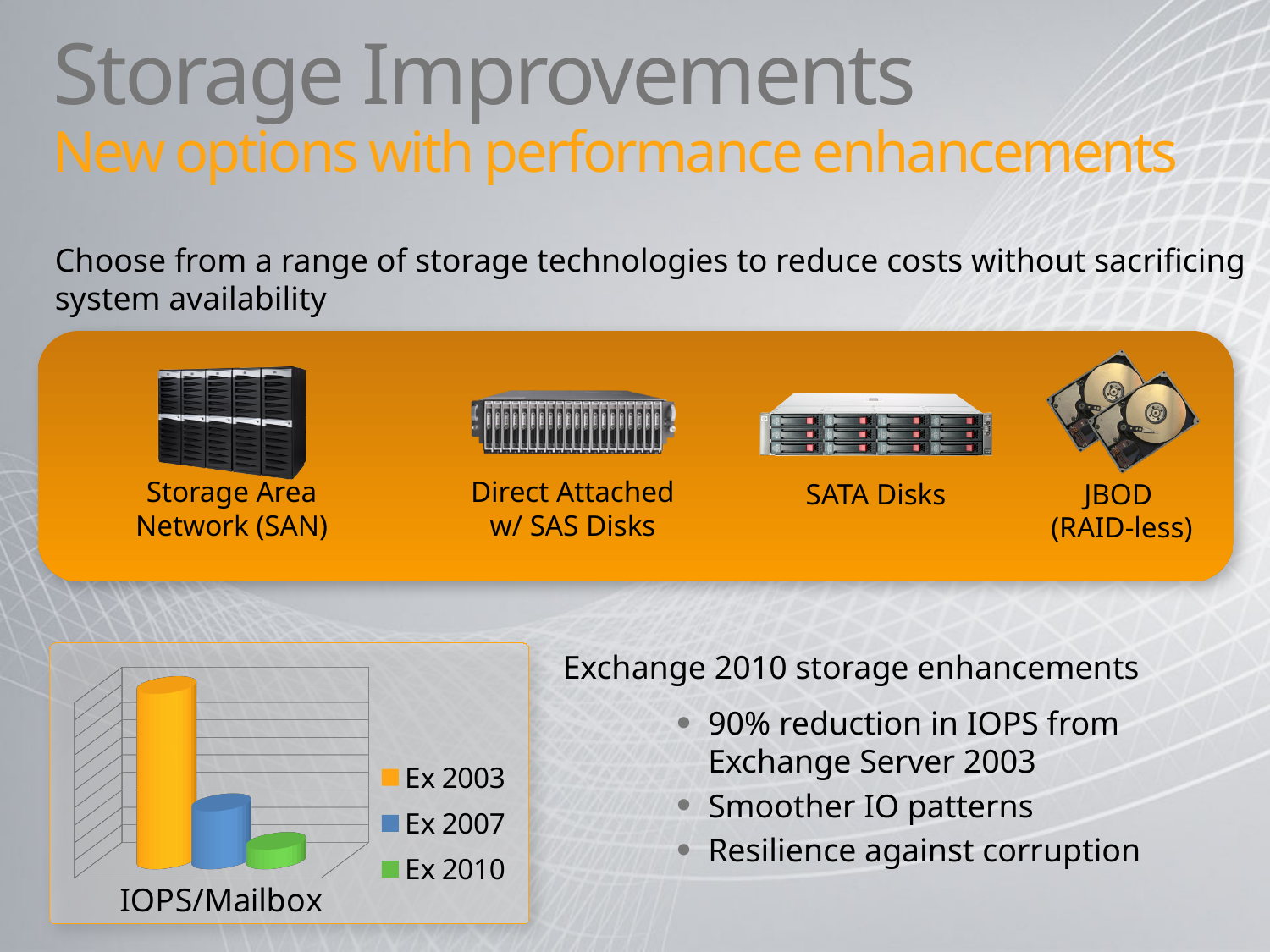
Which is larger in the chart, the IOPS/Mailbox value for Ex 2003 or for Ex 2007? Ex 2003 Do the IOPS/Mailbox values in the chart rise or fall from Ex 2003 to Ex 2010? fall How many categories are shown on the chart's x axis? 1 Which colour represents the Ex 2010 series in the chart's legend? green Which series has the highest IOPS/Mailbox value in the chart? Ex 2003 How many series does the chart's legend list? 3 What is the category label shown beneath the chart? IOPS/Mailbox What kind of chart is shown on the slide? bar chart Which is larger in the chart, the IOPS/Mailbox value for Ex 2007 or for Ex 2010? Ex 2007 Which series has the lowest IOPS/Mailbox value in the chart? Ex 2010